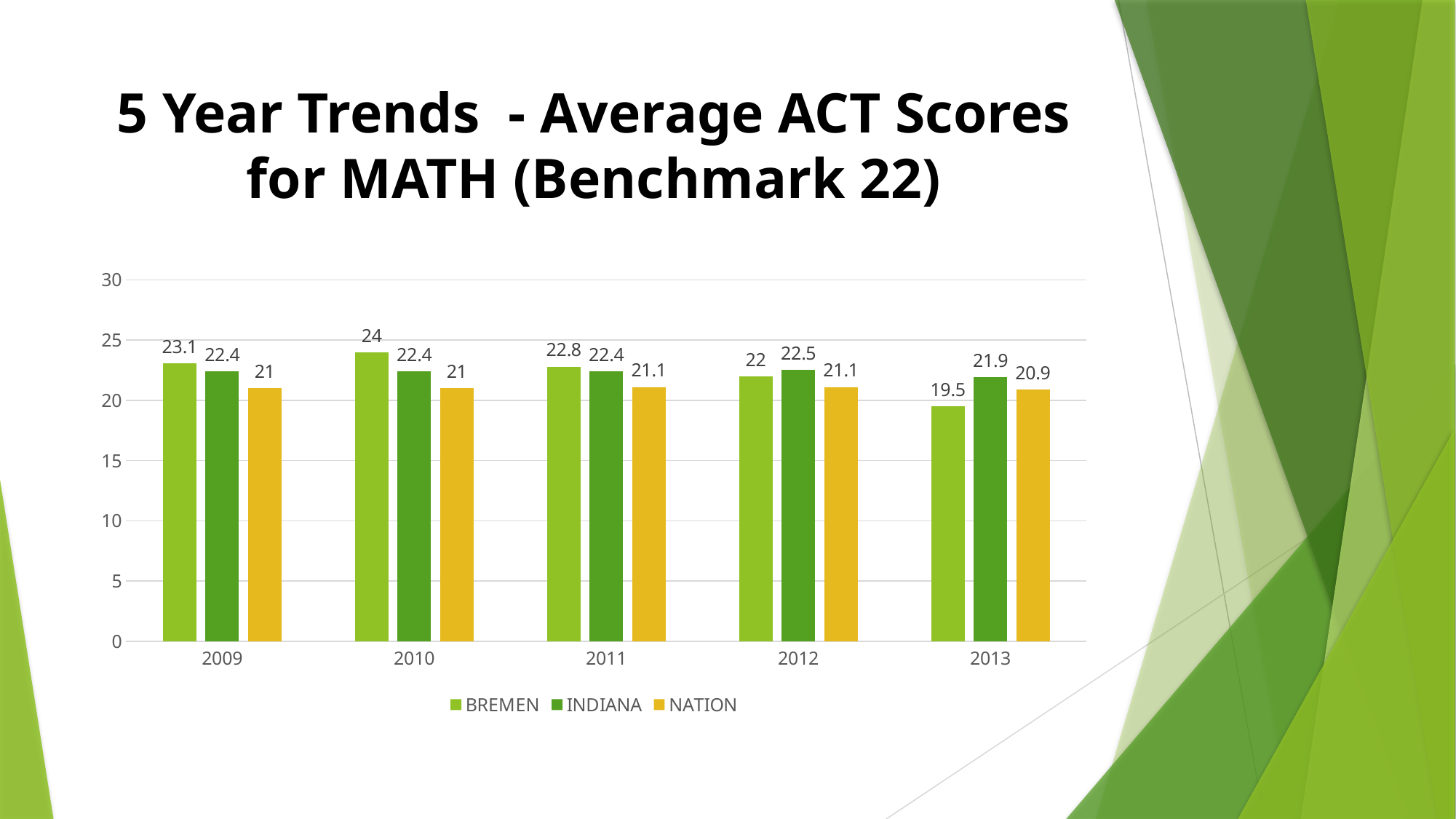
How many years are shown on the x axis? 5 What is the difference between the BREMEN and NATION scores in 2010? 3 Does the NATION score rise or fall from 2012 to 2013? Fall In which year was the BREMEN score lowest? 2013 What was the NATION average ACT math score in 2013? 20.9 What is the difference between the INDIANA and BREMEN scores in 2013? 2.4 What kind of chart is shown on the slide? Bar chart What was the INDIANA average ACT math score in 2012? 22.5 In which year was the BREMEN score highest? 2010 How many series does the legend list? 3 What was the BREMEN average ACT math score in 2010? 24 Which was higher in 2012, BREMEN or INDIANA? INDIANA